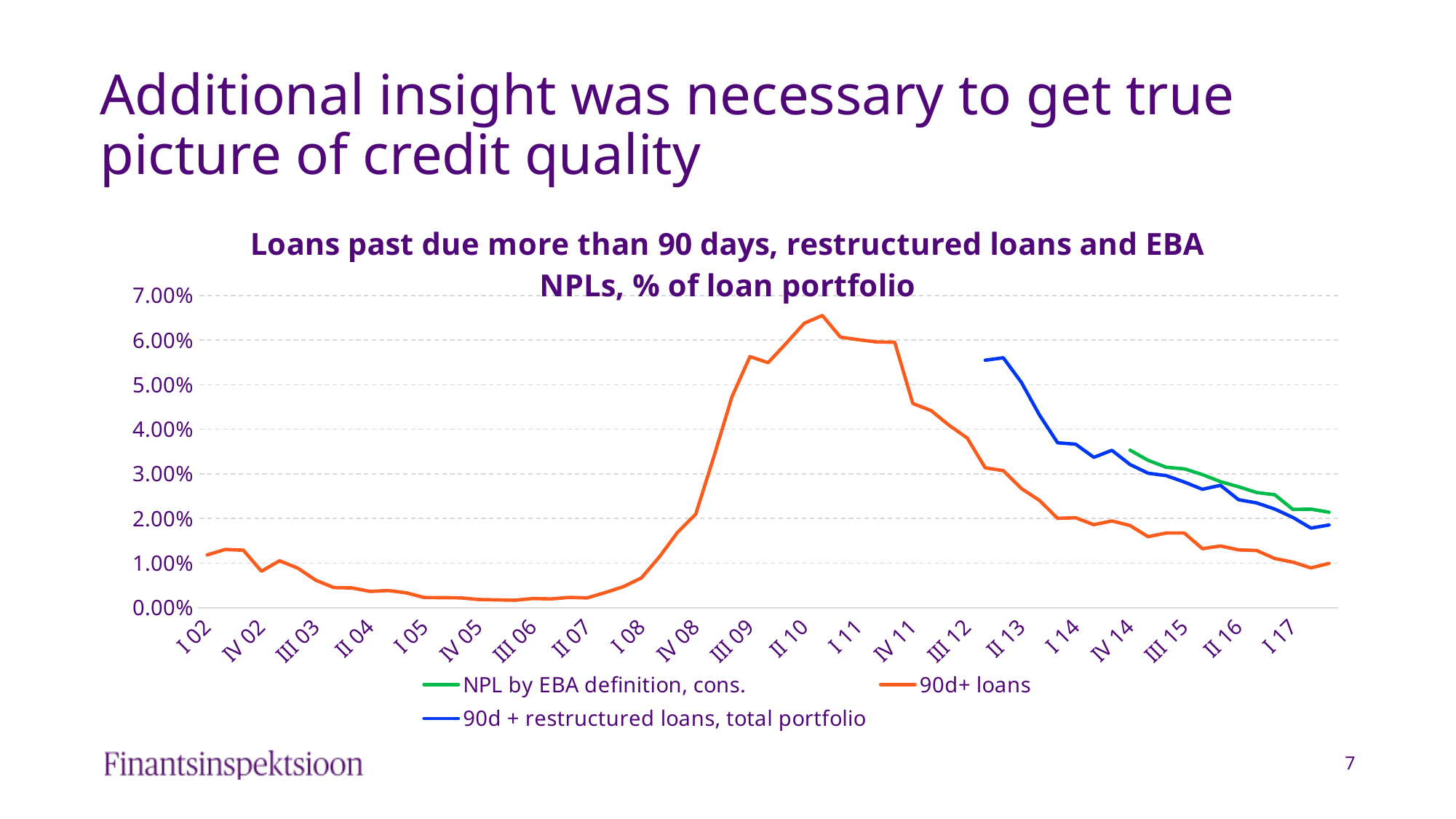
Is the value for 'NPL by EBA definition, cons.' at IV 14 greater or less than 3.00%? greater How many series does the legend list? 3 What kind of chart is shown on the slide? line chart At IV 14, which series has the higher value: 'NPL by EBA definition, cons.' or '90d+ loans'? NPL by EBA definition, cons. Does the '90d+ loans' series rise or fall between I 08 and II 10? rise Is the value for '90d+ loans' at III 06 greater or less than 1.00%? less What is the title of the chart? Loans past due more than 90 days, restructured loans and EBA NPLs, % of loan portfolio Which series reaches the highest value anywhere on the chart? 90d+ loans Which colour is used for the '90d+ loans' series? orange Does the '90d+ loans' series rise or fall between II 10 and I 17? fall Is the value for '90d+ loans' at II 10 greater or less than 6.00%? greater